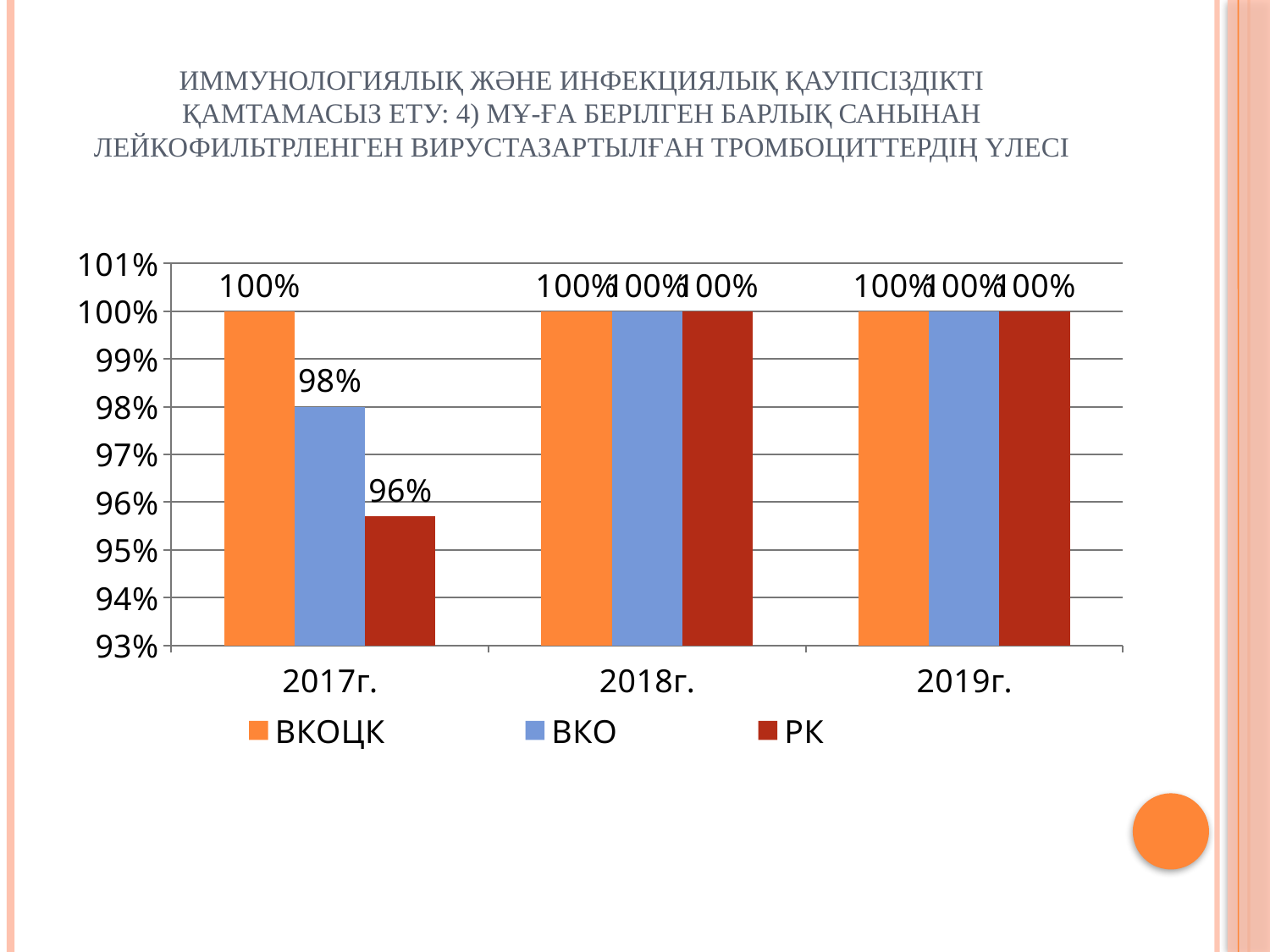
How many series does the legend list? 3 How many year categories are shown on the x axis? 3 Which series has the highest value in 2017г.? ВКОЦК What kind of chart is shown on the slide? bar chart Does the value for РК rise or fall from 2017г. to 2018г.? rise What is the value for ВКОЦК in 2017г.? 100% What is the difference between the ВКОЦК and РК values in 2017г.? 4% What is the value for ВКО in 2017г.? 98% What is the value for РК in 2019г.? 100% What is the value for РК in 2017г.? 96% Which is larger in 2017г., the value for ВКО or the value for РК? ВКО Which series has the lowest value in 2017г.? РК